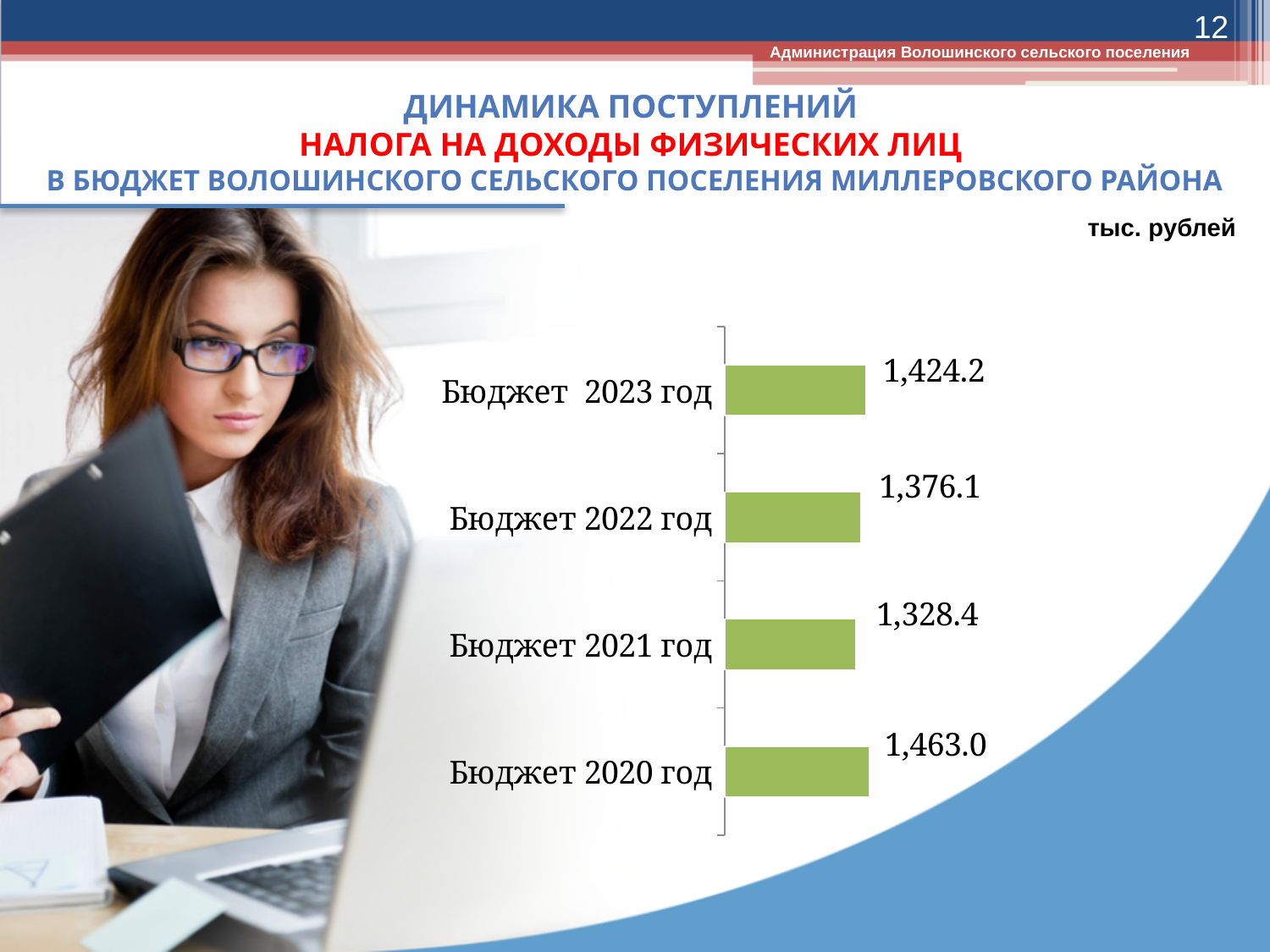
What is the value for Бюджет 2020 год? 1,463.0 What is the difference between the values for Бюджет 2023 год and Бюджет 2022 год? 48.1 Which is larger, the value for Бюджет 2022 год or Бюджет 2023 год? Бюджет 2023 год What is the value for Бюджет 2023 год? 1,424.2 Which category has the lowest value? Бюджет 2021 год What is the difference between the values for Бюджет 2020 год and Бюджет 2021 год? 134.6 What is the value for Бюджет 2021 год? 1,328.4 What is the value for Бюджет 2022 год? 1,376.1 How many categories are shown in the chart? 4 Which category has the highest value? Бюджет 2020 год In what units are the chart values given? тыс. рублей What kind of chart is shown on the slide? Bar chart